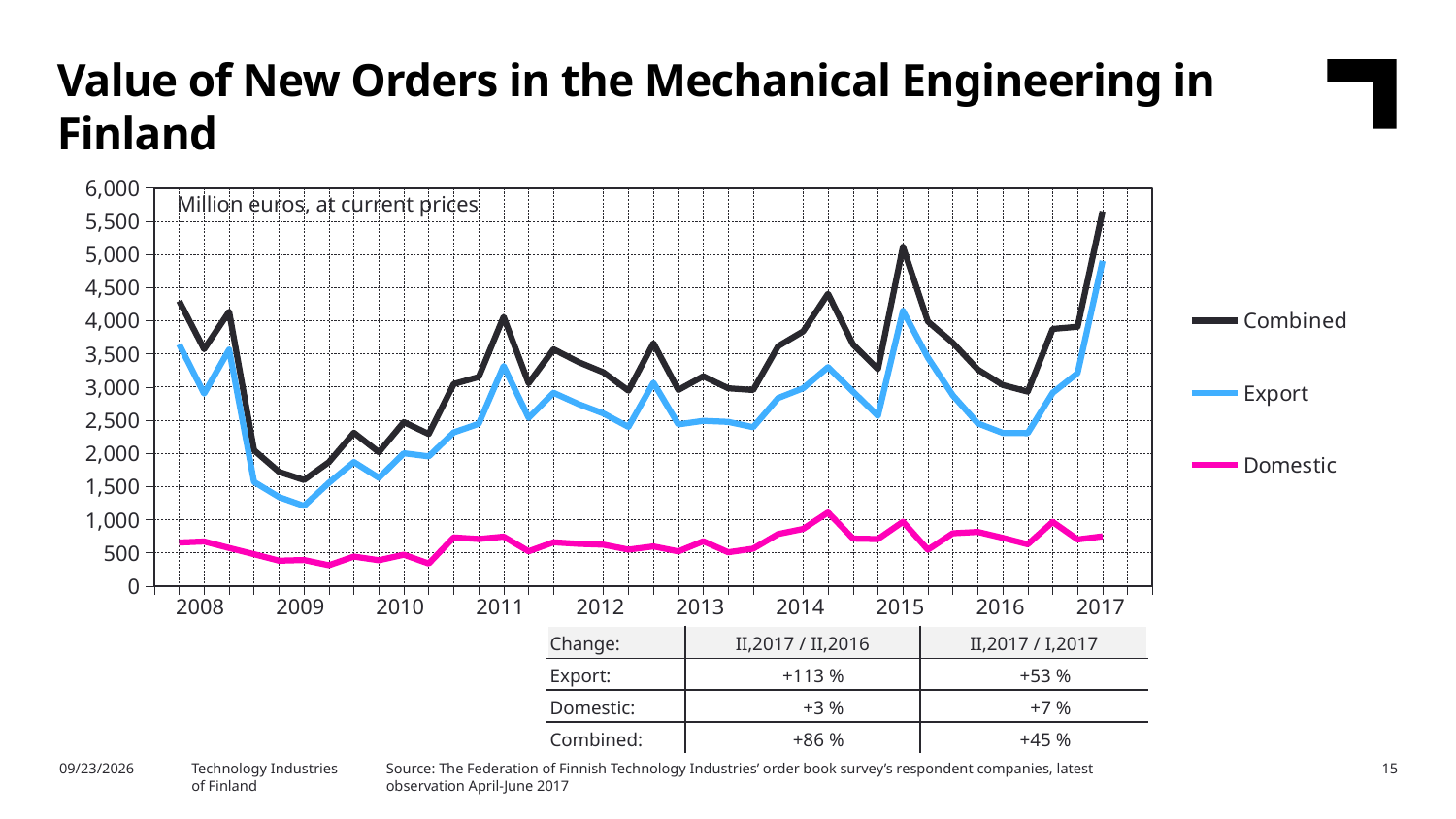
How many years are labelled on the x axis? 10 Which series has the highest values throughout the chart? Combined How many series does the legend list? 3 Is the value of the Export series at the last point in 2017 greater or less than 4,500? greater According to the change table below the chart, what is the Export change for II,2017 / II,2016? +113 % Is the value of the Combined series at the last point in 2017 greater or less than 5,000? greater Is the Domestic series ever greater than 1,500 at any point on the chart? No Does the Combined series rise or fall from its 2015 peak to 2016? fall At the last point in 2017, which is larger, Export or Domestic? Export Which series has the lowest values throughout the chart? Domestic What kind of chart is shown on the slide? line chart